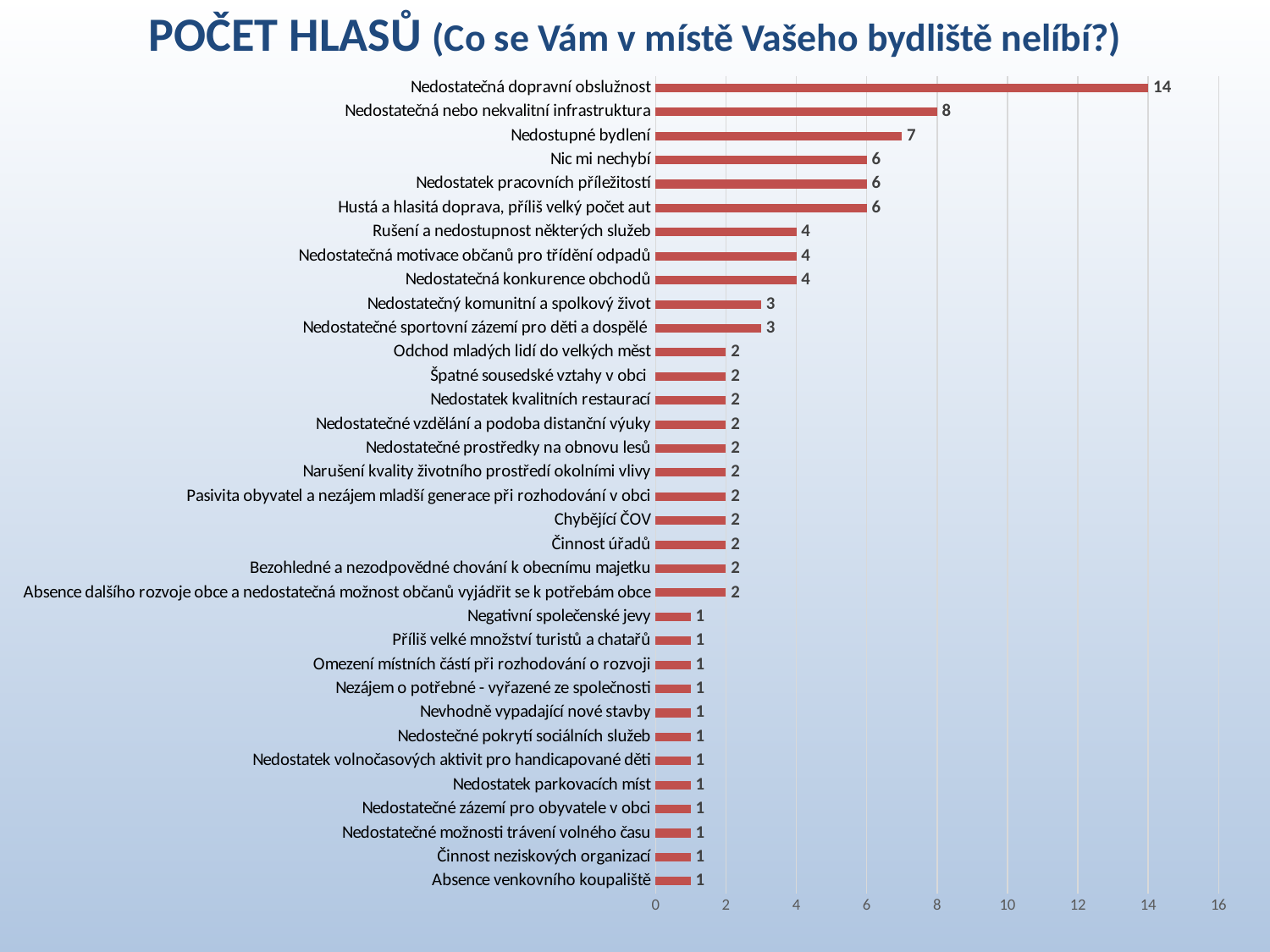
What is the difference between "Nedostatečná dopravní obslužnost" and "Nedostatečná nebo nekvalitní infrastruktura"? 6 What is the value for "Chybějící ČOV"? 2 What is the title of the chart? POČET HLASŮ (Co se Vám v místě Vašeho bydliště nelíbí?) How many categories are shown in the chart? 34 What kind of chart is shown on the slide? bar chart Which is larger, the value for "Nic mi nechybí" or the value for "Rušení a nedostupnost některých služeb"? Nic mi nechybí What is the value for "Nedostatečná dopravní obslužnost"? 14 Is the value for "Nedostatečná nebo nekvalitní infrastruktura" greater or less than 6? greater Which category has the highest value? Nedostatečná dopravní obslužnost What is the value for "Nedostatečná konkurence obchodů"? 4 What is the value for "Nedostupné bydlení"? 7 What is the difference between "Nedostupné bydlení" and "Nedostatečný komunitní a spolkový život"? 4